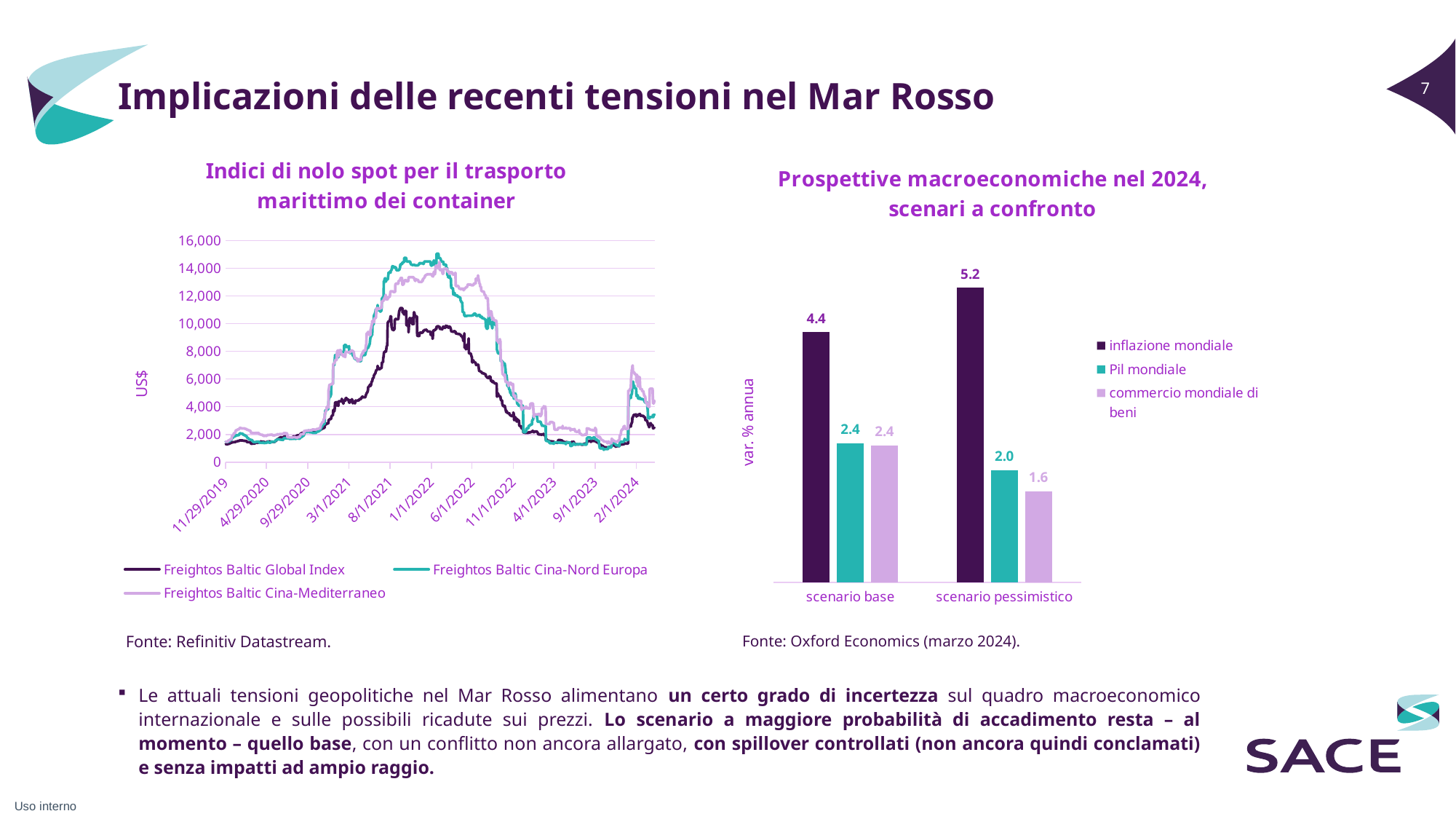
How many series does the legend of the chart 'Prospettive macroeconomiche nel 2024, scenari a confronto' list? 3 In the chart 'Indici di nolo spot per il trasporto marittimo dei container', is the peak value of the Freightos Baltic Cina-Nord Europa series greater or less than 14,000? greater How many series does the legend of the chart 'Indici di nolo spot per il trasporto marittimo dei container' list? 3 In the chart 'Prospettive macroeconomiche nel 2024, scenari a confronto', what is the difference between inflazione mondiale in the scenario pessimistico and in the scenario base? 0.8 In the chart 'Prospettive macroeconomiche nel 2024, scenari a confronto', what is the value for commercio mondiale di beni in the scenario pessimistico? 1.6 In the chart 'Prospettive macroeconomiche nel 2024, scenari a confronto', what is the value for Pil mondiale in the scenario pessimistico? 2.0 In the chart 'Prospettive macroeconomiche nel 2024, scenari a confronto', what is the value for inflazione mondiale in the scenario base? 4.4 What is the y-axis label of the chart 'Indici di nolo spot per il trasporto marittimo dei container'? US$ In the chart 'Prospettive macroeconomiche nel 2024, scenari a confronto', which series has the highest value in the scenario pessimistico? inflazione mondiale What kind of chart is 'Indici di nolo spot per il trasporto marittimo dei container'? line chart How many scenario categories are shown on the x axis of the chart 'Prospettive macroeconomiche nel 2024, scenari a confronto'? 2 In the chart 'Prospettive macroeconomiche nel 2024, scenari a confronto', is Pil mondiale higher in the scenario base or in the scenario pessimistico? scenario base